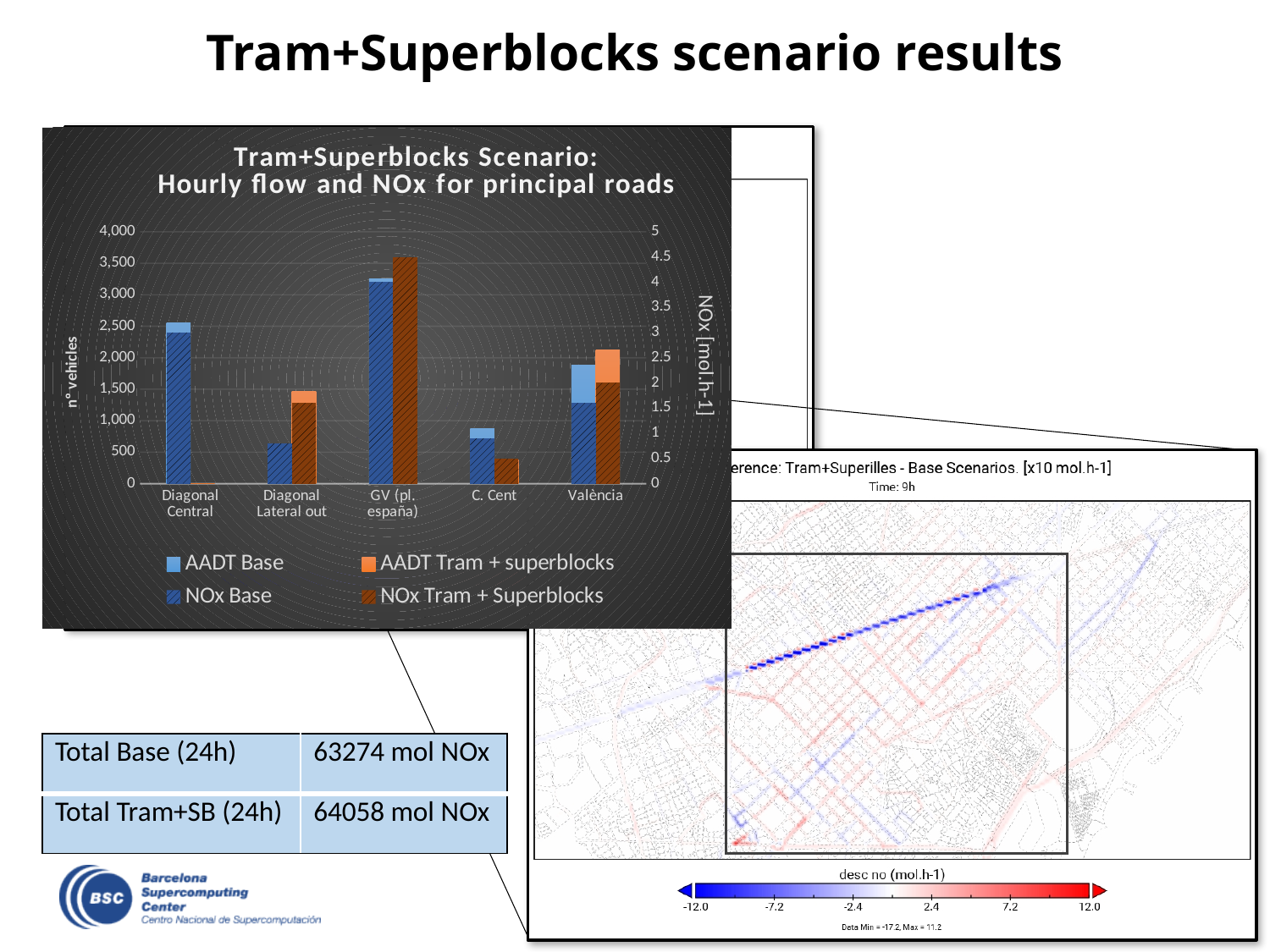
Is the AADT Base value for C. Cent greater or less than 1,000? less Which road has the highest NOx Tram + Superblocks value? GV (pl. españa) Which road has the lowest AADT Base value? Diagonal Lateral out Which road has the highest AADT Base value? GV (pl. españa) What is the label of the right-hand vertical axis of the chart? NOx [mol.h-1] What is the title of the chart? Tram+Superblocks Scenario: Hourly flow and NOx for principal roads How many road categories are shown on the x axis of the chart? 5 Is the AADT Base value for Diagonal Central greater or less than 2,000? greater Which is larger, the AADT Base value for Diagonal Central or for Diagonal Lateral out? Diagonal Central How many series does the chart's legend list? 4 What kind of chart is shown on the slide? bar chart